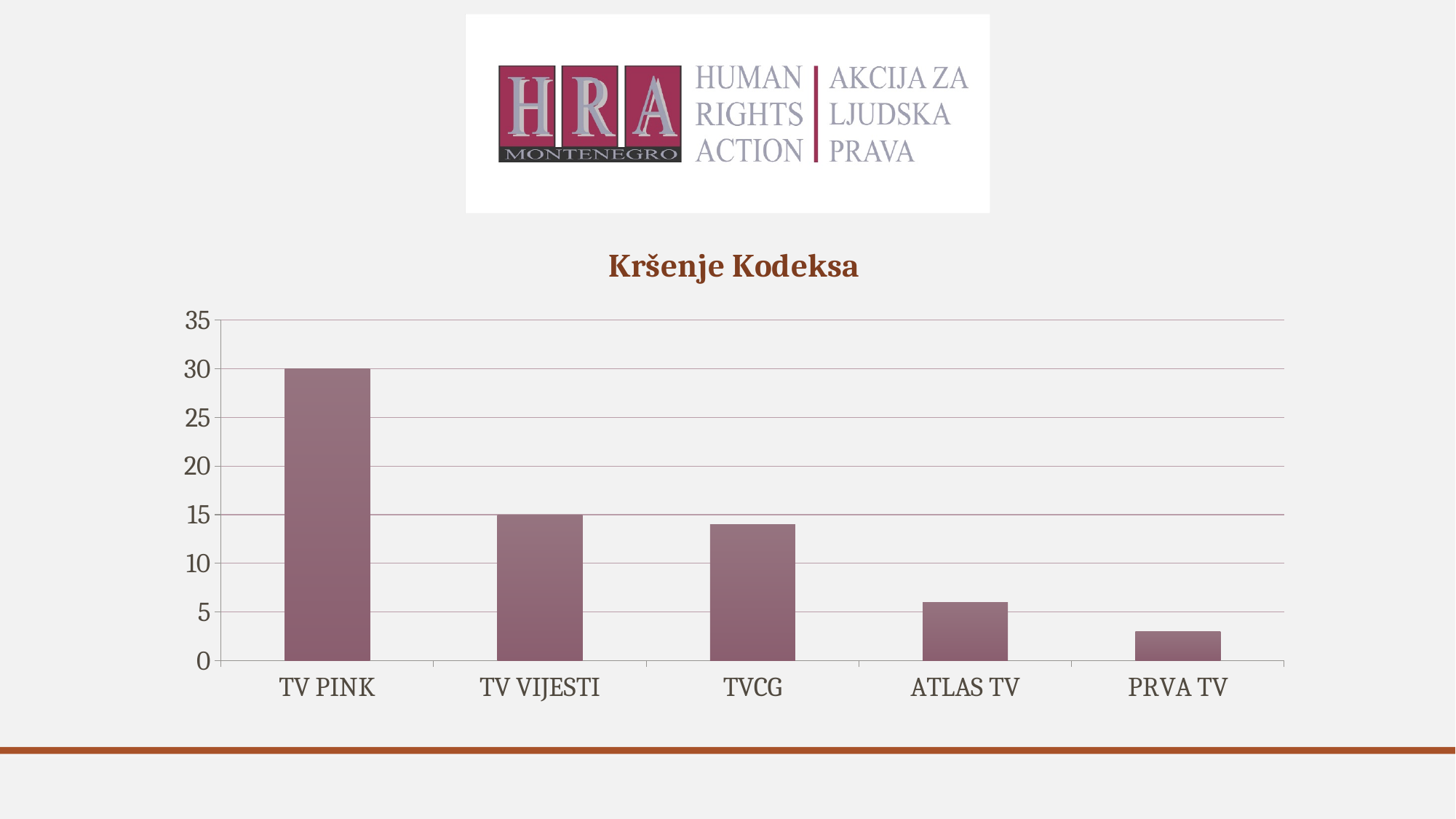
Which is larger, the value for TV PINK or the value for ATLAS TV? TV PINK Is the value for TVCG greater or less than 10? greater What kind of chart is shown on the slide? bar chart What is the title of the chart? Kršenje Kodeksa Which category has the highest value in the chart? TV PINK What is the value for TV PINK? 30 What is the difference between the values for TV PINK and TV VIJESTI? 15 What is the value for TV VIJESTI? 15 Do the values rise or fall moving from left to right along the x axis? fall Is the value for ATLAS TV greater or less than 10? less Which category has the lowest value in the chart? PRVA TV How many categories are shown on the x axis of the chart? 5